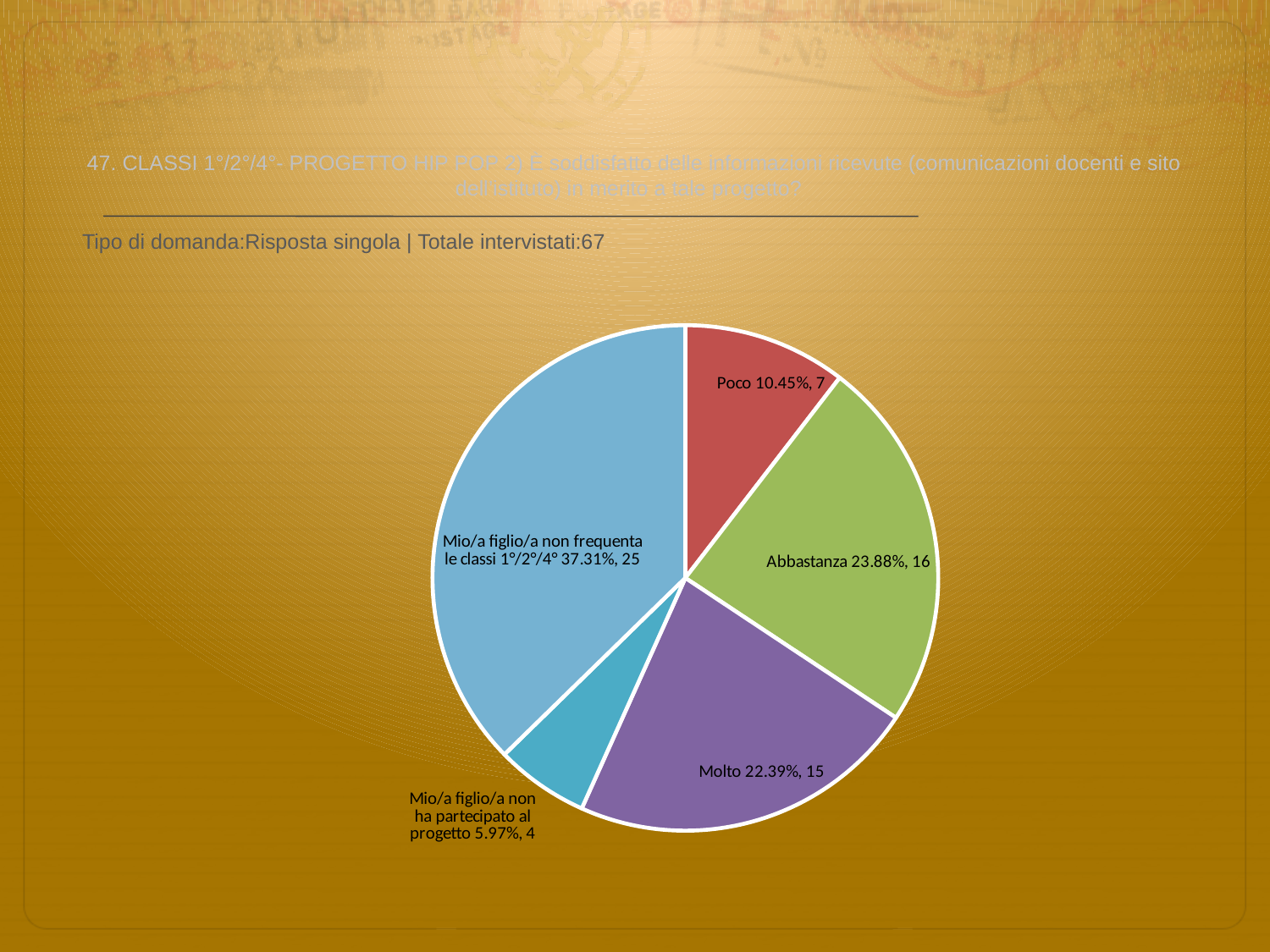
How many slices does the pie chart have? 5 What is the total number of respondents shown on the slide? 67 What colour is the "Molto" slice of the pie? purple How many respondents answered "Molto"? 15 What percentage of the pie does the "Poco" slice represent? 10.45% Which category has the smallest slice of the pie? Mio/a figlio/a non ha partecipato al progetto Which has more respondents, "Poco" or "Mio/a figlio/a non ha partecipato al progetto"? Poco What kind of chart is shown on the slide? pie chart What is the difference in number of respondents between "Abbastanza" and "Molto"? 1 Which category has the largest slice of the pie? Mio/a figlio/a non frequenta le classi 1°/2°/4° What percentage of the pie does the "Mio/a figlio/a non frequenta le classi 1°/2°/4°" slice represent? 37.31% How many respondents answered "Abbastanza"? 16